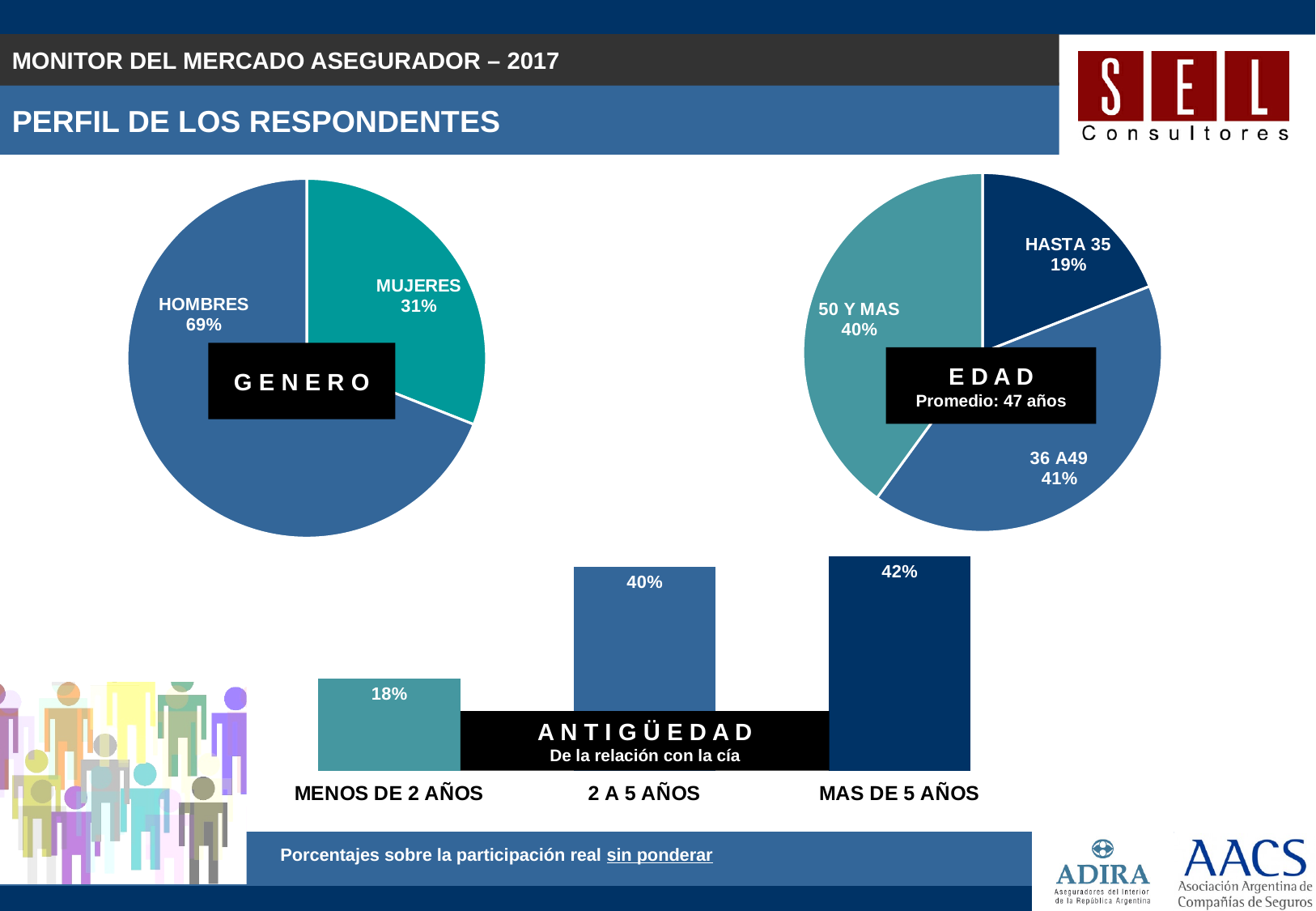
In the EDAD pie chart, what percentage is shown for HASTA 35? 19% In the ANTIGÜEDAD bar chart, what is the value for MAS DE 5 AÑOS? 42% In the EDAD pie chart, which category has the smallest share? HASTA 35 What average age (Promedio) is stated in the EDAD pie chart? 47 años What kind of chart is the ANTIGÜEDAD chart at the bottom of the slide? Bar chart In the GENERO pie chart, which category is larger, HOMBRES or MUJERES? HOMBRES In the GENERO pie chart, what percentage is shown for HOMBRES? 69% In the GENERO pie chart, what share of the pie does MUJERES represent? 31% In the ANTIGÜEDAD bar chart, which category has the lowest value? MENOS DE 2 AÑOS In the ANTIGÜEDAD bar chart, what is the difference between MAS DE 5 AÑOS and MENOS DE 2 AÑOS? 24% In the GENERO pie chart, what is the difference between the HOMBRES and MUJERES percentages? 38% How many slices does the EDAD pie chart have? 3